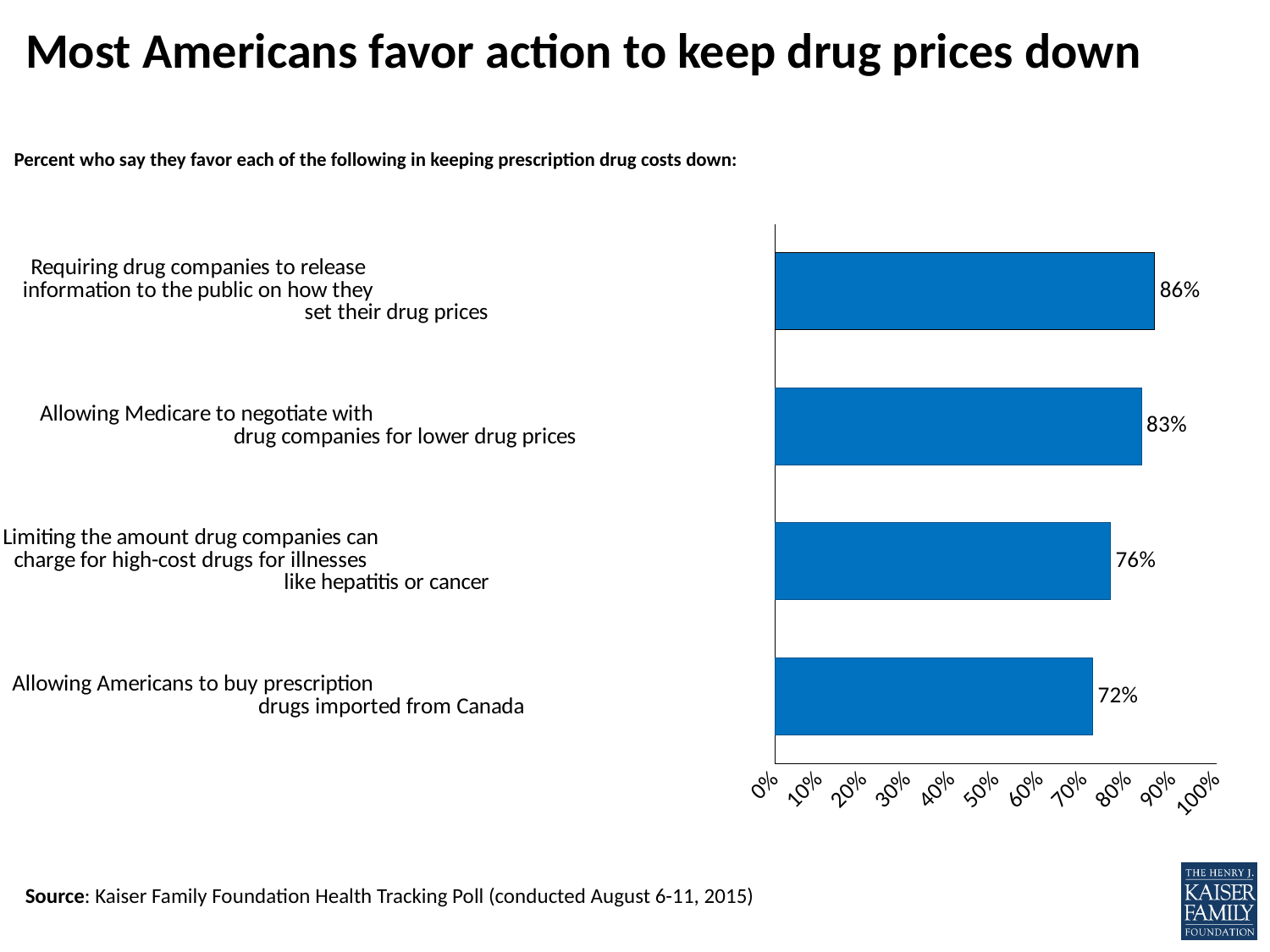
What is the title of the slide? Most Americans favor action to keep drug prices down Which has a higher percent in favor: allowing Medicare to negotiate with drug companies or limiting what drug companies can charge for high-cost drugs? Allowing Medicare to negotiate with drug companies for lower drug prices Which proposal has the highest percent in favor? Requiring drug companies to release information to the public on how they set their drug prices Which proposal has the lowest percent in favor? Allowing Americans to buy prescription drugs imported from Canada What kind of chart is shown on the slide? Bar chart What is the difference in percentage points between the share favoring requiring drug companies to release pricing information and the share favoring allowing imports from Canada? 14 percentage points What percent favor allowing Americans to buy prescription drugs imported from Canada? 72% What percent favor allowing Medicare to negotiate with drug companies for lower drug prices? 83% How many proposals are shown in the chart? 4 What percent favor requiring drug companies to release information to the public on how they set their drug prices? 86% Is the value for allowing Americans to buy prescription drugs imported from Canada greater or less than 80%? less What percent favor limiting the amount drug companies can charge for high-cost drugs for illnesses like hepatitis or cancer? 76%